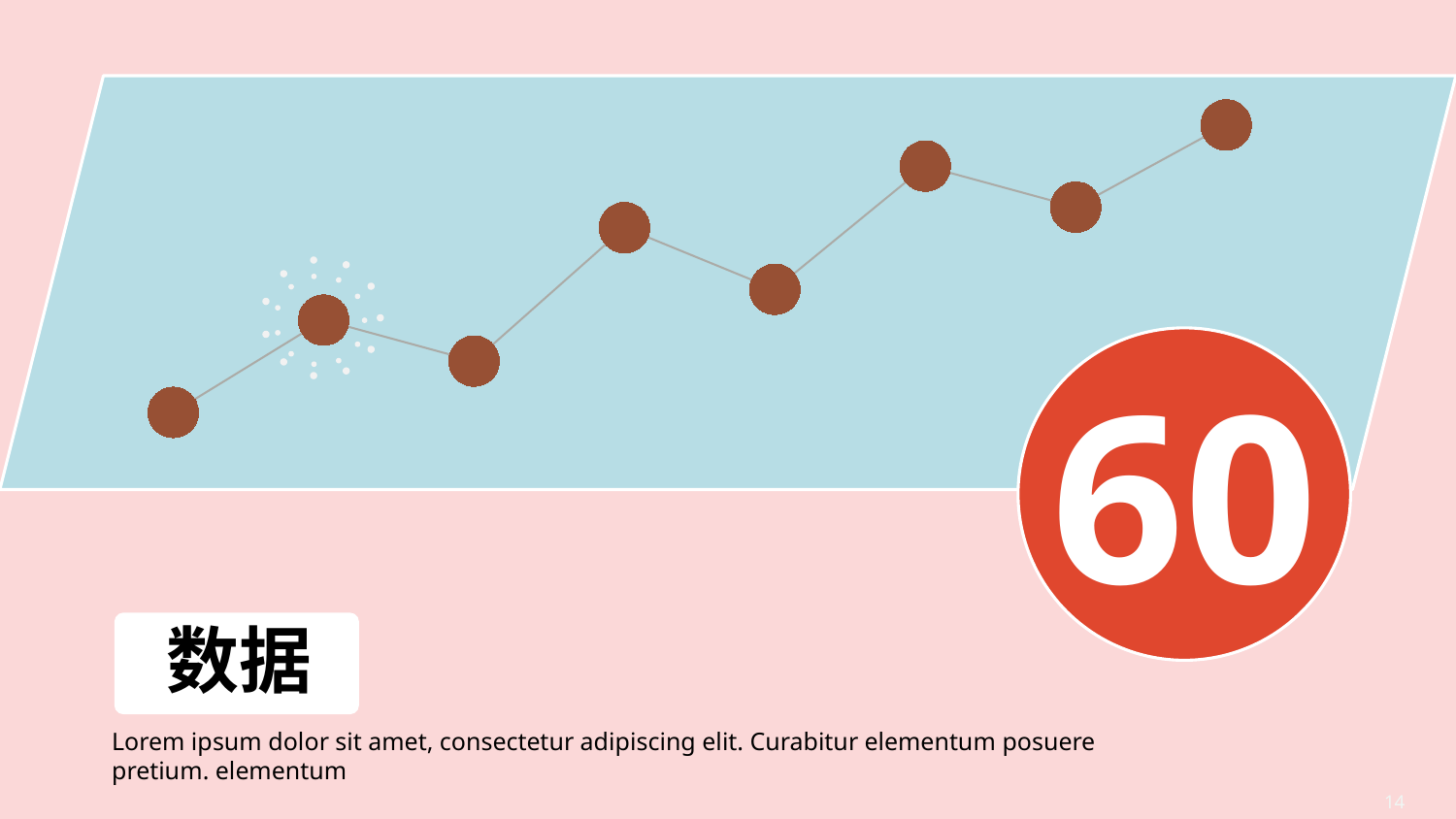
Which is higher on the line chart, the leftmost point or the rightmost point? the rightmost point Which point on the line chart is the highest? the rightmost (last) point What is the title text shown in the white box below the chart? 数据 Which point on the line chart is the lowest? the leftmost (first) point How many data points are plotted on the line chart? 8 What large number is shown in the red circle next to the chart? 60 What kind of chart is shown on the slide? line chart Do the values on the line chart generally rise or fall from left to right? rise